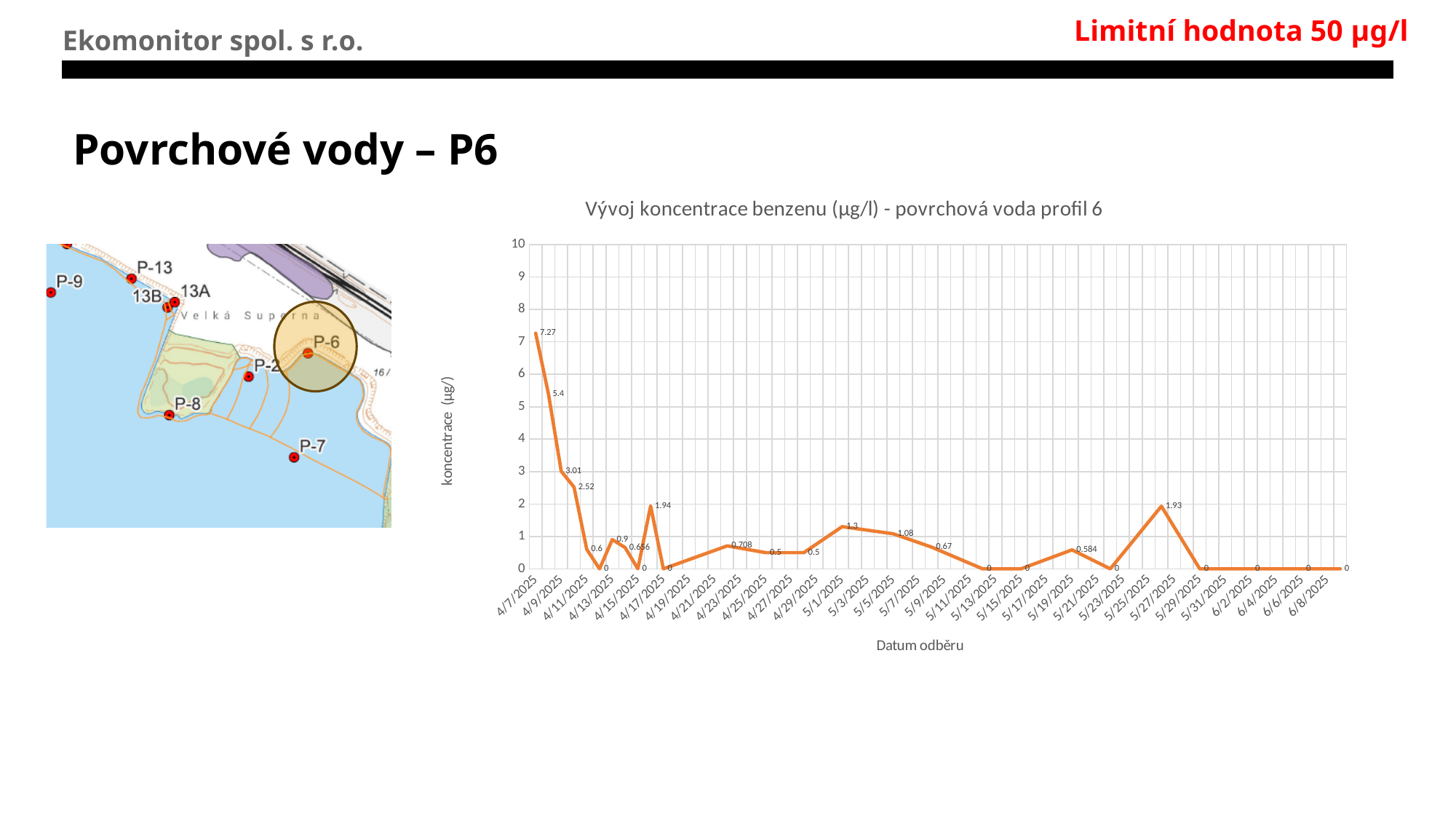
What is the benzene concentration on 5/19/2025? 0.584 What kind of chart is shown on the slide? line chart What is the highest benzene concentration plotted on the chart? 7.27 Is the concentration on 4/7/2025 greater or less than 5? greater What is the benzene concentration on 5/5/2025? 1.08 What is the benzene concentration on 5/1/2025? 1.3 What is the difference between the concentration on 4/7/2025 and on 4/9/2025? 4.26 Which date has the higher concentration, 5/1/2025 or 5/5/2025? 5/1/2025 What is the benzene concentration on 4/7/2025? 7.27 What is the label of the x axis of the chart? Datum odběru What is the title of the chart? Vývoj koncentrace benzenu (µg/l) - povrchová voda profil 6 What is the value of the peak in late May (between 5/25/2025 and 5/27/2025)? 1.93